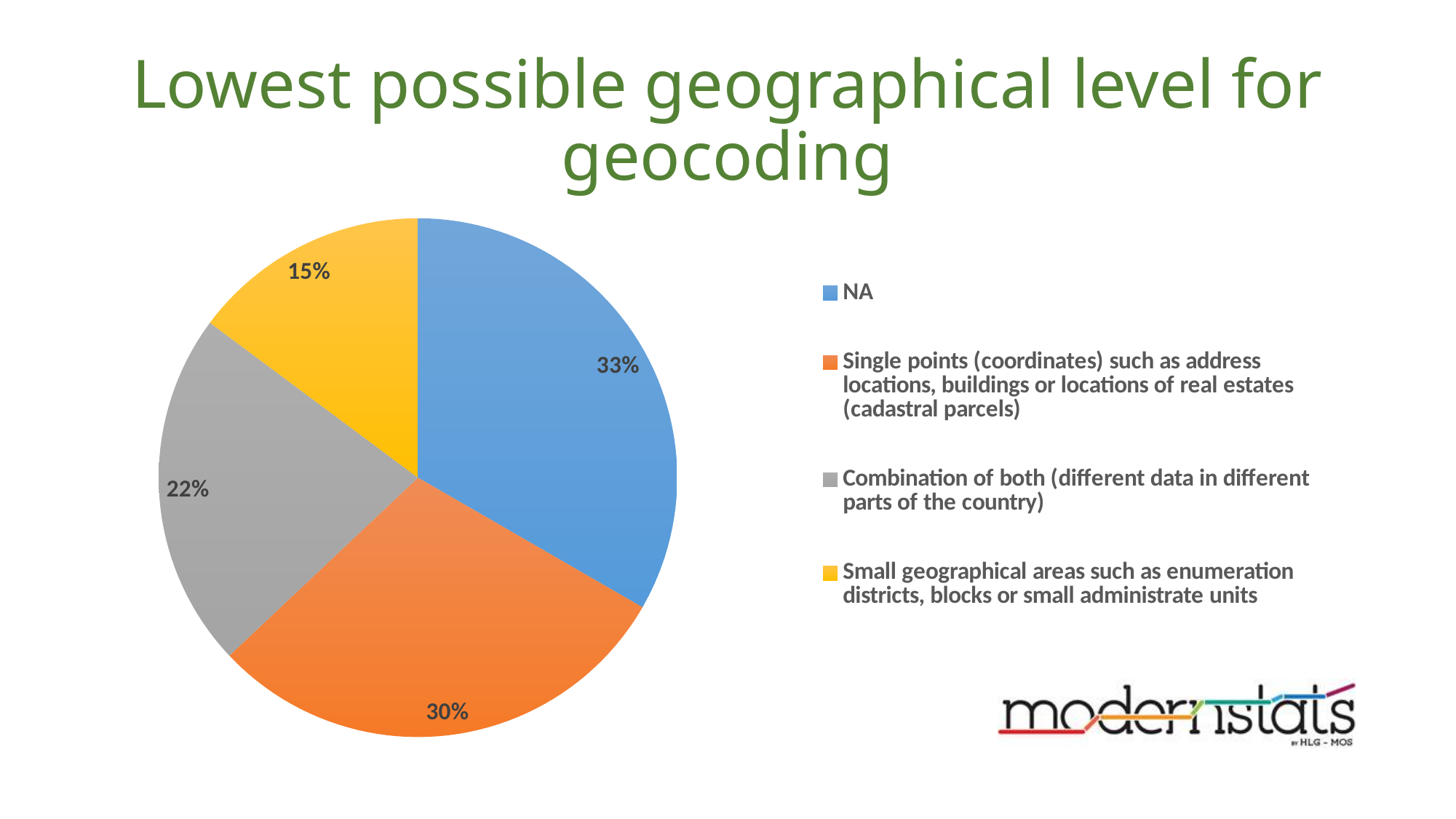
Which is larger: the slice for Single points (coordinates) or the slice for Small geographical areas? Single points (coordinates) What share of the pie is for Small geographical areas such as enumeration districts, blocks or small administrate units? 15% What is the title of the chart on the slide? Lowest possible geographical level for geocoding What kind of chart is shown on the slide? pie chart What share of the pie is for Combination of both (different data in different parts of the country)? 22% What is the difference in percentage points between the NA slice and the Combination of both slice? 11 How many slices does the pie chart have? 4 What share of the pie is for Single points (coordinates) such as address locations, buildings or locations of real estates (cadastral parcels)? 30% How many entries does the legend list? 4 Which category has the smallest slice of the pie? Small geographical areas such as enumeration districts, blocks or small administrate units What share of the pie is labelled NA? 33% Which category has the largest slice of the pie? NA